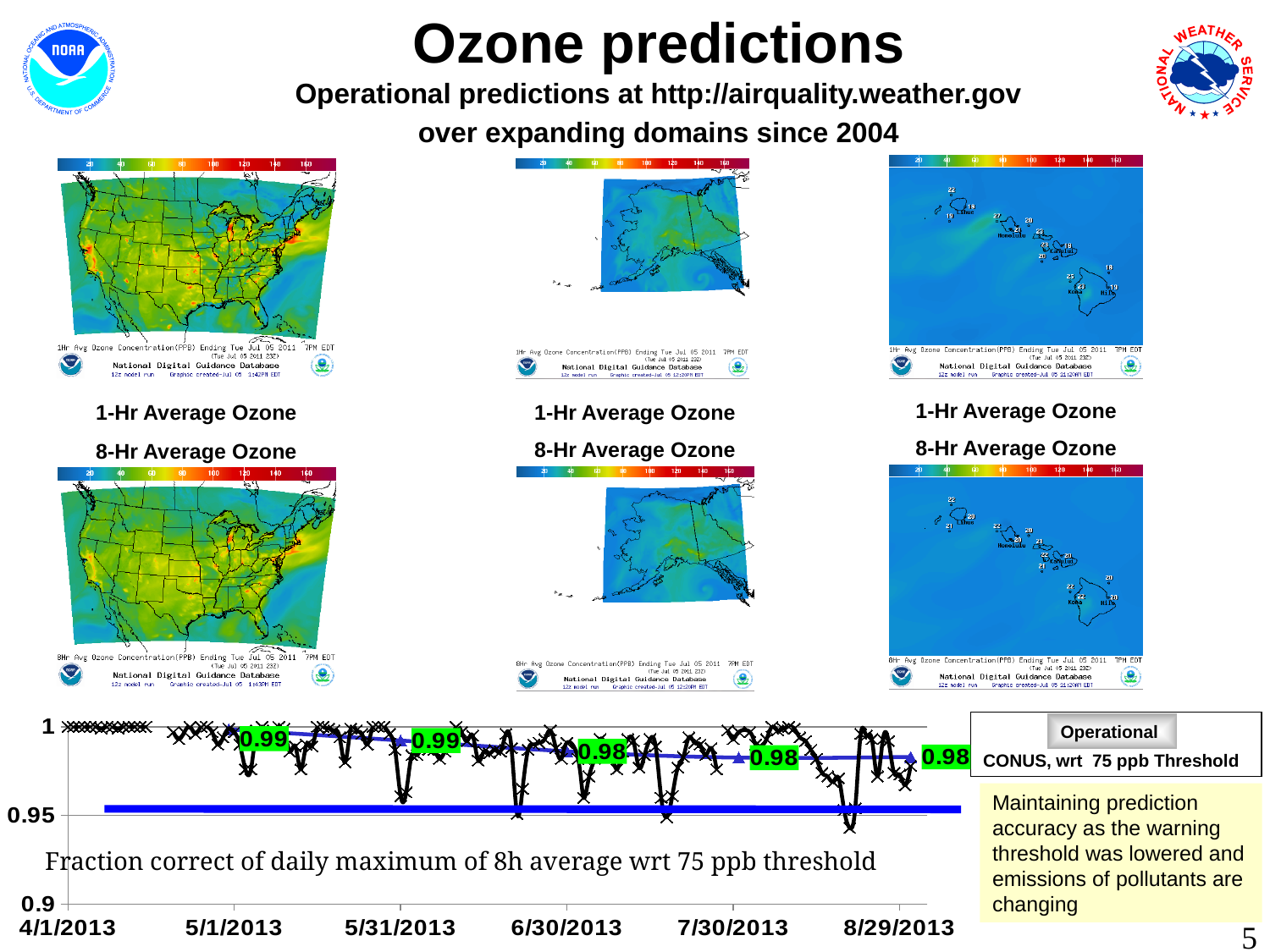
In the bottom line chart, is the first labeled value (0.99) greater or less than 0.95? greater How many date labels are shown on the x axis of the bottom line chart? 6 In the bottom line chart, which is larger: the first labeled value or the last labeled value? the first labeled value (0.99) What kind of chart is shown at the bottom of the slide? line chart In the bottom line chart, what is the last labeled value shown at the right end of the line? 0.98 In the bottom line chart, do the labeled values rise or fall from left to right? fall What is the lowest value shown on the y axis of the bottom line chart? 0.9 In the bottom line chart, what is the difference between the first labeled value and the last labeled value? 0.01 In the bottom line chart, what is the first date shown on the x axis? 4/1/2013 In the bottom line chart, what is the first labeled value shown along the line? 0.99 How many labeled values are printed along the line in the bottom chart? 5